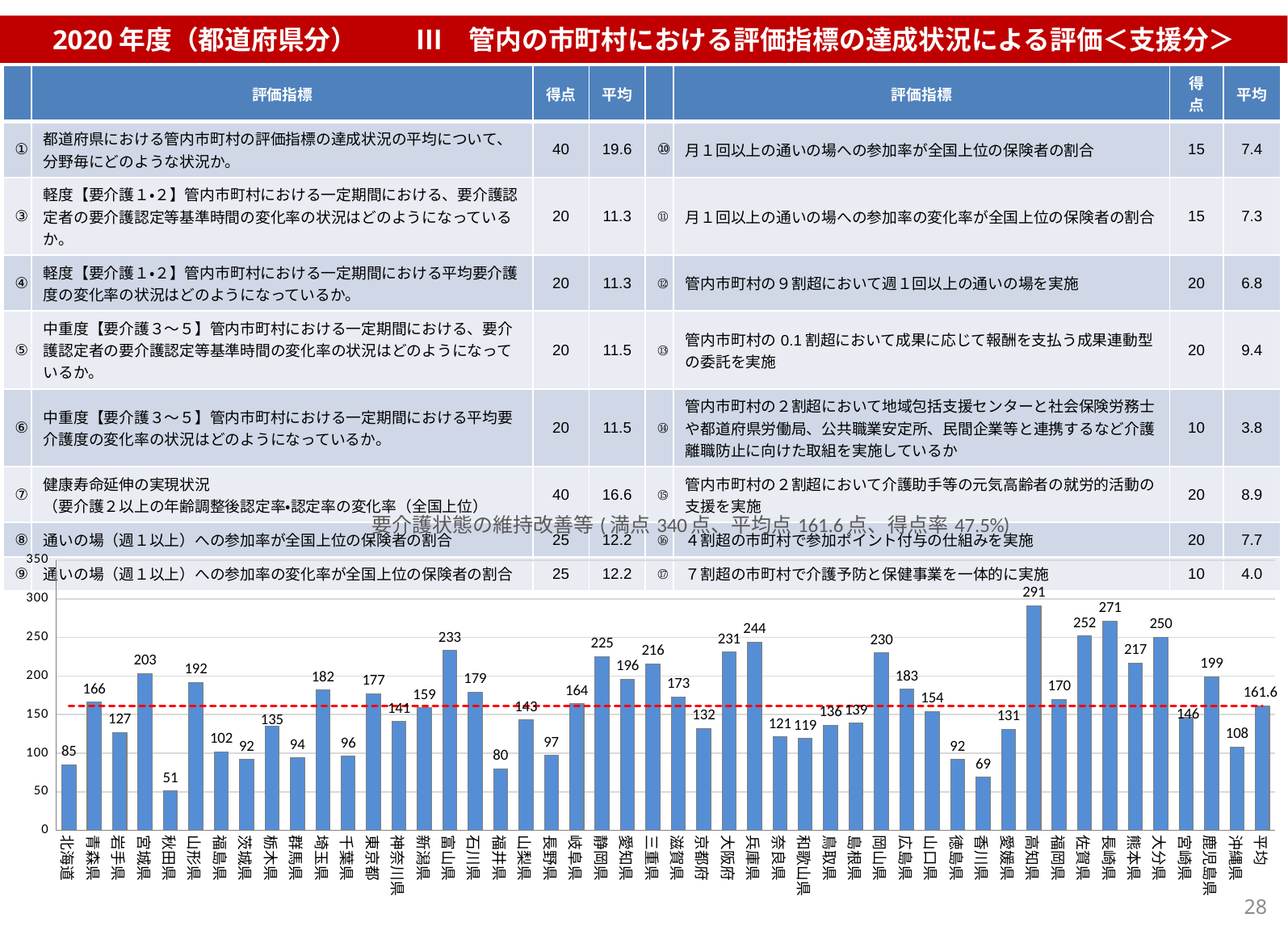
In the bar chart, what is the value shown for 平均 (the last bar)? 161.6 In the bar chart, which is larger, the value for 兵庫県 or the value for 大阪府? 兵庫県 In the bar chart, what is the value for 高知県? 291 What type of chart is shown at the bottom of the slide? bar chart In the bar chart, is the value for 香川県 greater or less than 100? less In the bar chart, what is the value for 北海道? 85 What is the difference between the values for 宮城県 and 福島県 in the bar chart? 101 What value does the red dashed horizontal line in the bar chart represent? 161.6 In the bar chart, what is the value for 秋田県? 51 Which prefecture has the lowest bar in the chart? 秋田県 Which prefecture has the highest bar in the chart? 高知県 What is the difference between the values for 長崎県 and 佐賀県 in the bar chart? 19